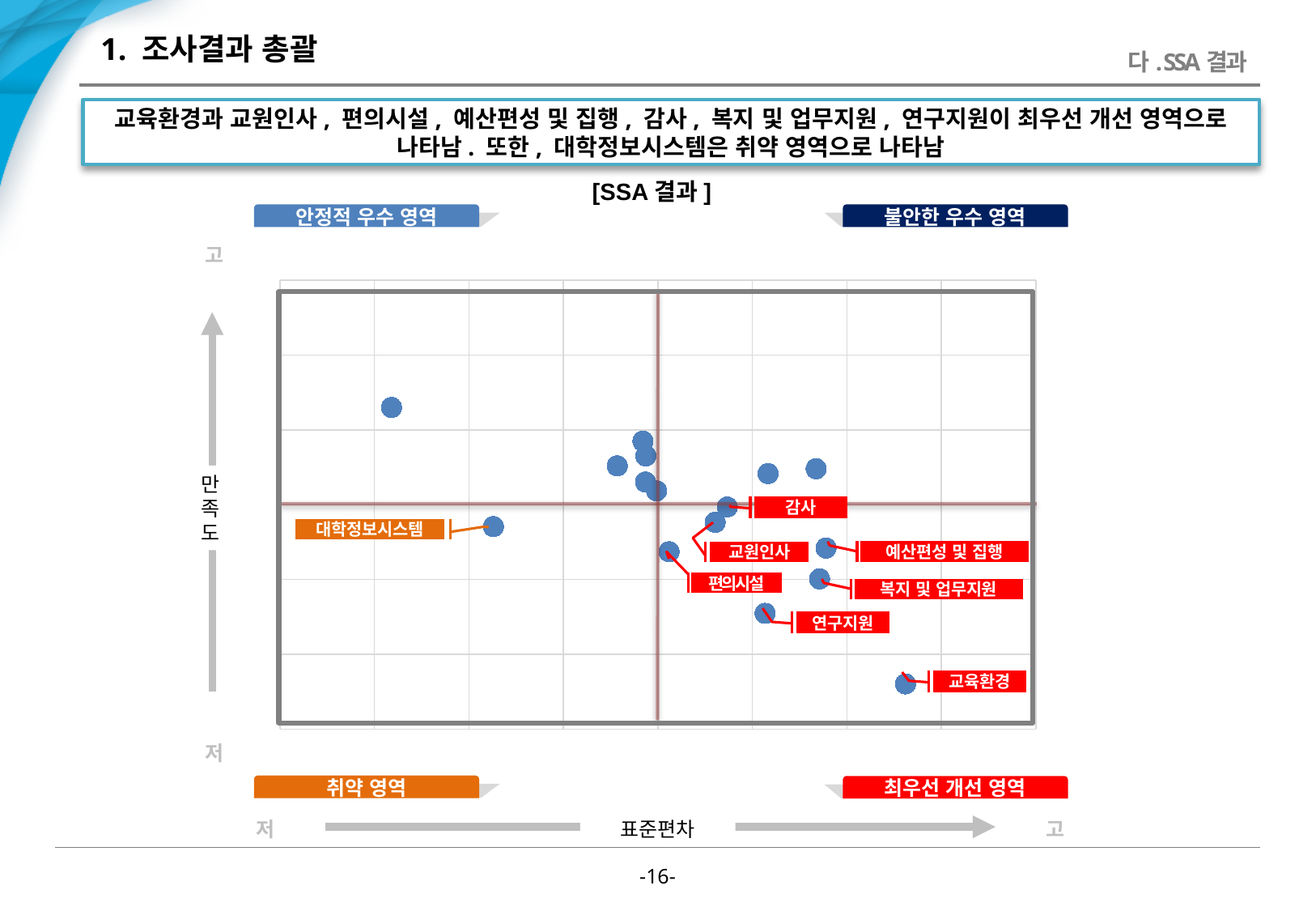
Which labeled point lies in the 취약 영역 (bottom-left) quadrant? 대학정보시스템 What does the vertical axis of the chart represent? 만족도 Among the labeled points, which has the highest satisfaction (만족도)? 감사 Which labeled point has the lowest satisfaction (만족도) on the chart? 교육환경 What kind of chart is shown on the slide? scatter chart Which has the higher standard deviation (표준편차): 교육환경 or 연구지원? 교육환경 Which labeled point has the lowest standard deviation (표준편차)? 대학정보시스템 What is the title of the chart? [SSA 결과] Which has the higher satisfaction (만족도): 대학정보시스템 or 교육환경? 대학정보시스템 In which quadrant does the point labeled 연구지원 lie? 최우선 개선 영역 How many data points on the chart have a name label attached? 8 Which labeled point has the highest standard deviation (표준편차) on the chart? 교육환경